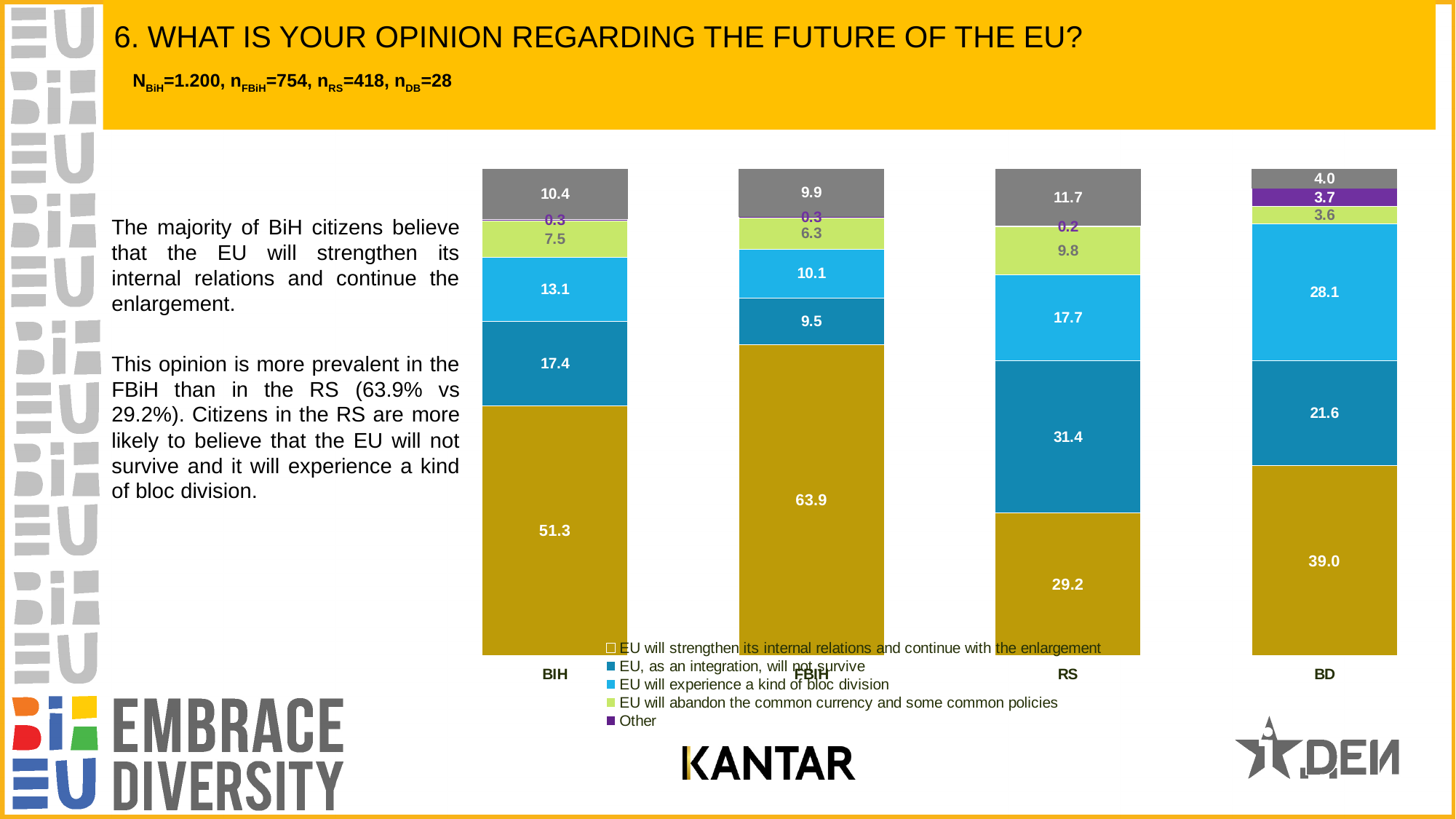
How many series does the chart's legend list? 5 What is the value for 'EU will experience a kind of bloc division' for BD? 28.1 How many categories (regions) are shown on the x axis of the chart? 4 Which region has the highest value for 'Other'? BD Which region has the lowest value for 'EU will strengthen its internal relations and continue with the enlargement'? RS What is the difference between the FBIH and RS values for 'EU will strengthen its internal relations and continue with the enlargement'? 34.7 What is the value for 'EU will abandon the common currency and some common policies' for BIH? 7.5 What kind of chart is shown on the slide? Stacked bar chart Which is larger for RS: 'EU, as an integration, will not survive' or 'EU will strengthen its internal relations and continue with the enlargement'? EU, as an integration, will not survive What is the value for 'EU, as an integration, will not survive' for RS? 31.4 What is the value for 'EU will strengthen its internal relations and continue with the enlargement' for FBIH? 63.9 Which region has the highest value for 'EU will strengthen its internal relations and continue with the enlargement'? FBIH